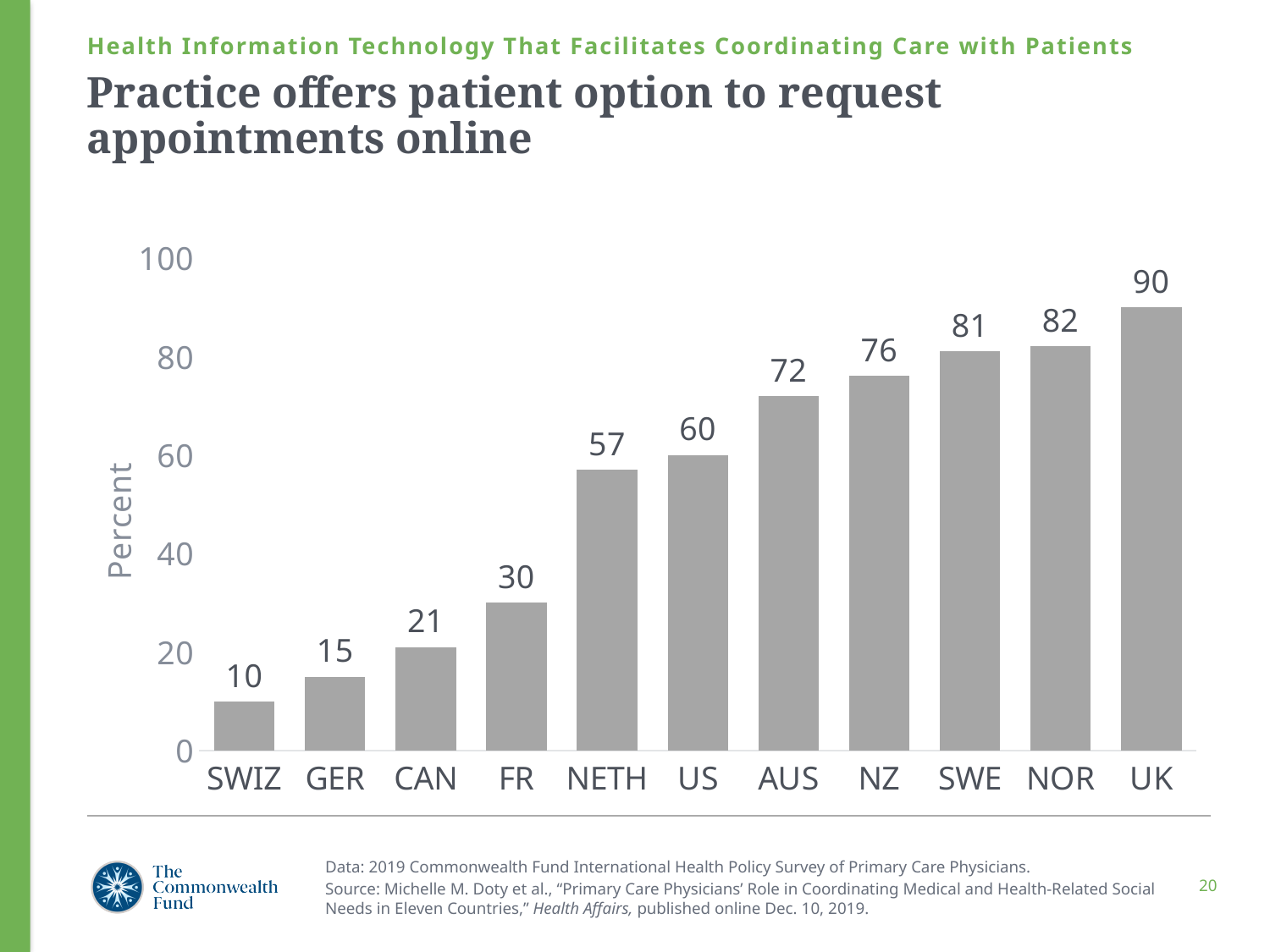
What is the value for CAN? 21 Is the value for GER greater or less than 20? less Which is larger, the value for AUS or the value for NZ? NZ What is the value for SWE? 81 What is the value for NETH? 57 How many countries are shown on the x axis? 11 What kind of chart is shown on the slide? bar chart What is the difference between the values for US and FR? 30 Do the values rise or fall from left to right along the x axis? rise Which country has the lowest value? SWIZ Which country has the highest value? UK What is the difference between the values for UK and SWIZ? 80